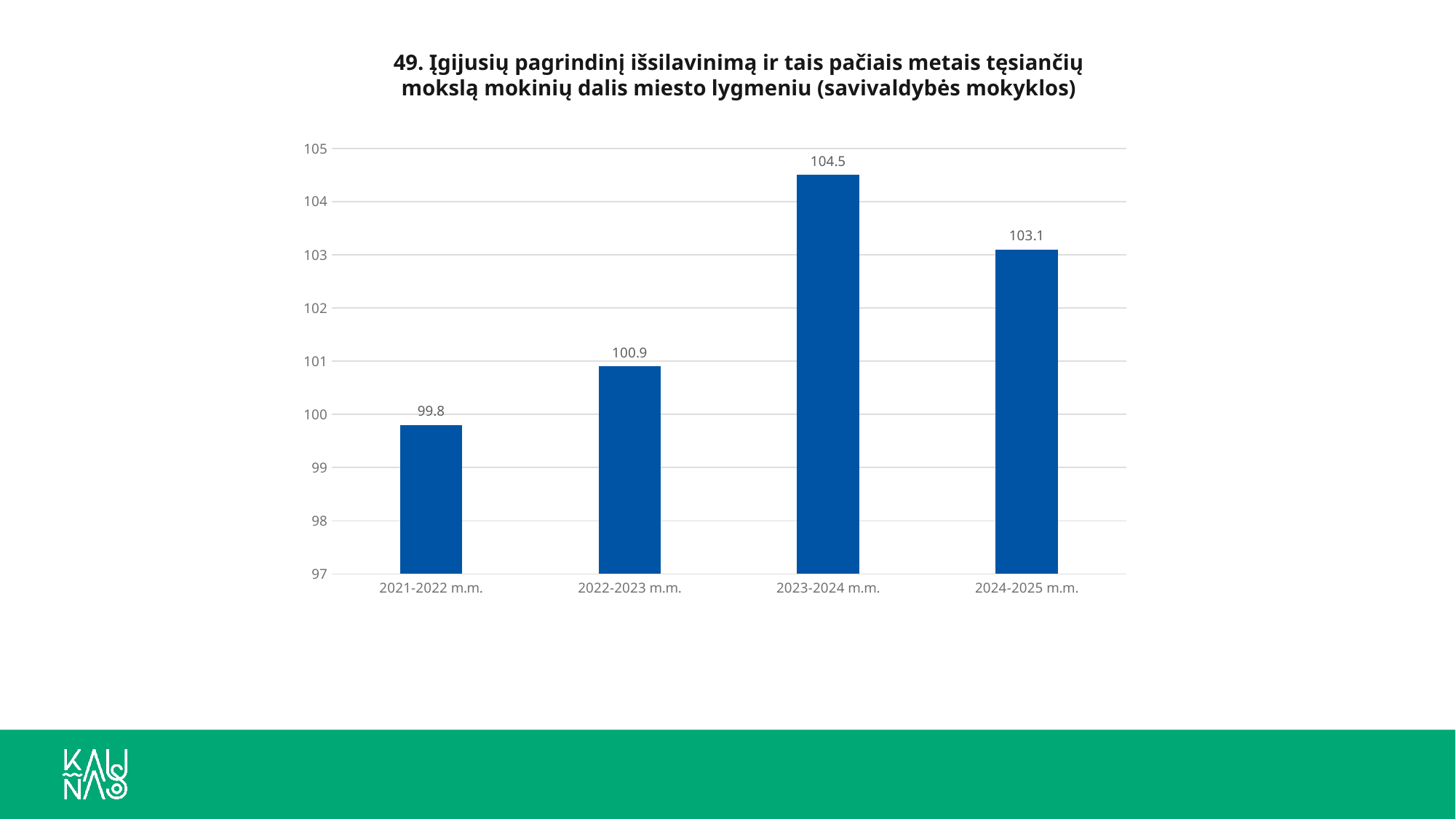
Is the value for 2021-2022 m.m. greater or less than 100? less What is the value for 2024-2025 m.m.? 103.1 What is the value for 2023-2024 m.m.? 104.5 Does the value rise or fall from 2021-2022 m.m. to 2023-2024 m.m.? rise Which is larger, the value for 2022-2023 m.m. or the value for 2024-2025 m.m.? 2024-2025 m.m. What is the difference between the values for 2023-2024 m.m. and 2022-2023 m.m.? 3.6 What kind of chart is shown on the slide? bar chart Which school year has the highest value? 2023-2024 m.m. Which school year has the lowest value? 2021-2022 m.m. What is the value for 2021-2022 m.m.? 99.8 What is the difference between the values for 2024-2025 m.m. and 2021-2022 m.m.? 3.3 How many school years are shown on the chart? 4